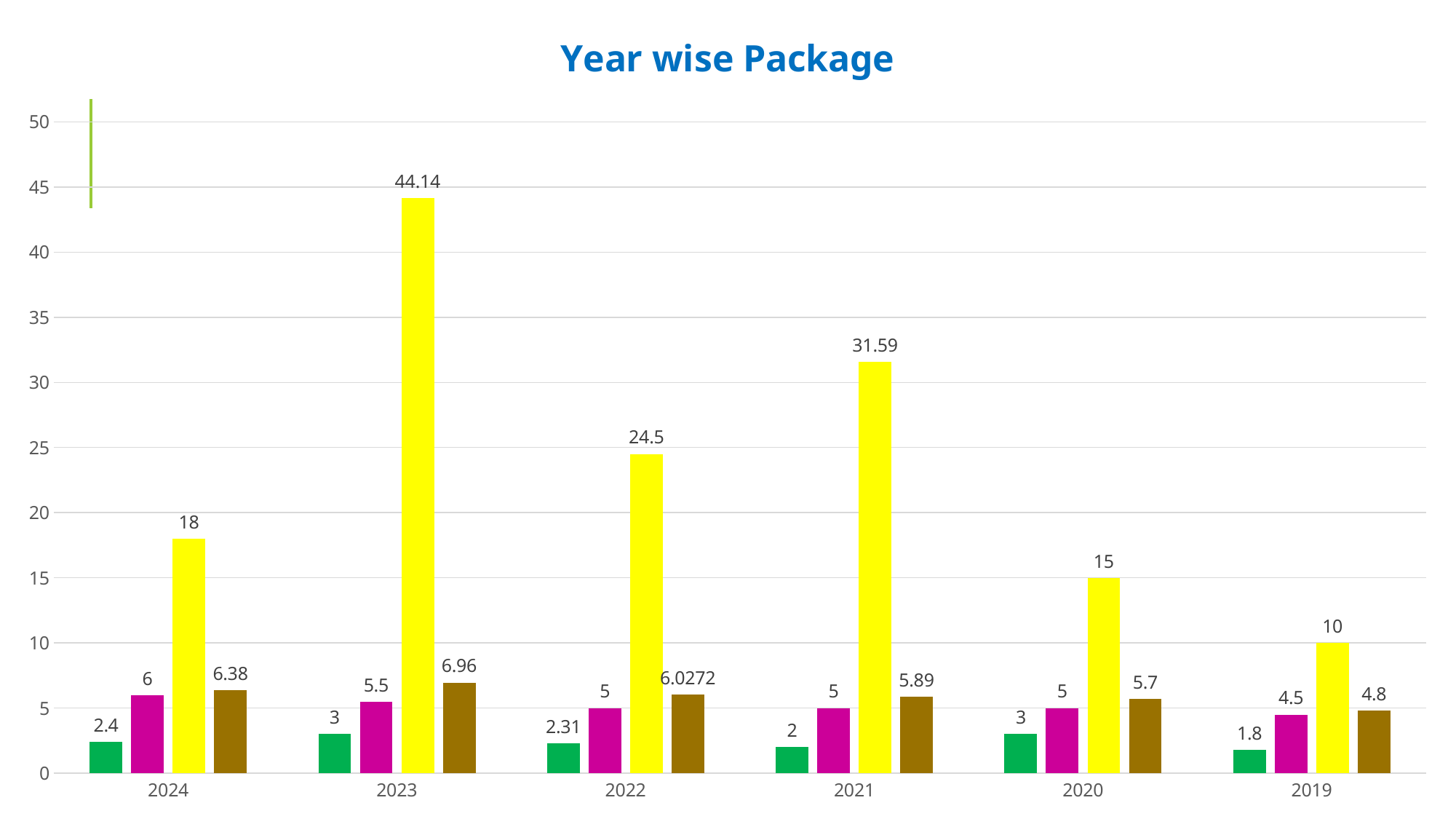
How many bars are plotted for each year? 4 Which year has the lowest yellow bar? 2019 Which is larger, the magenta bar for 2024 or the magenta bar for 2019? 2024 What is the title of the chart? Year wise Package How many years are shown on the x axis? 6 Which year has the highest yellow bar? 2023 What is the value of the green bar for 2019? 1.8 What kind of chart is shown on the slide? bar chart What is the value of the brown bar for 2022? 6.0272 What is the difference between the yellow bar values for 2023 and 2021? 12.55 Is the yellow bar for 2022 greater or less than 20? greater What is the value of the yellow bar for 2023? 44.14